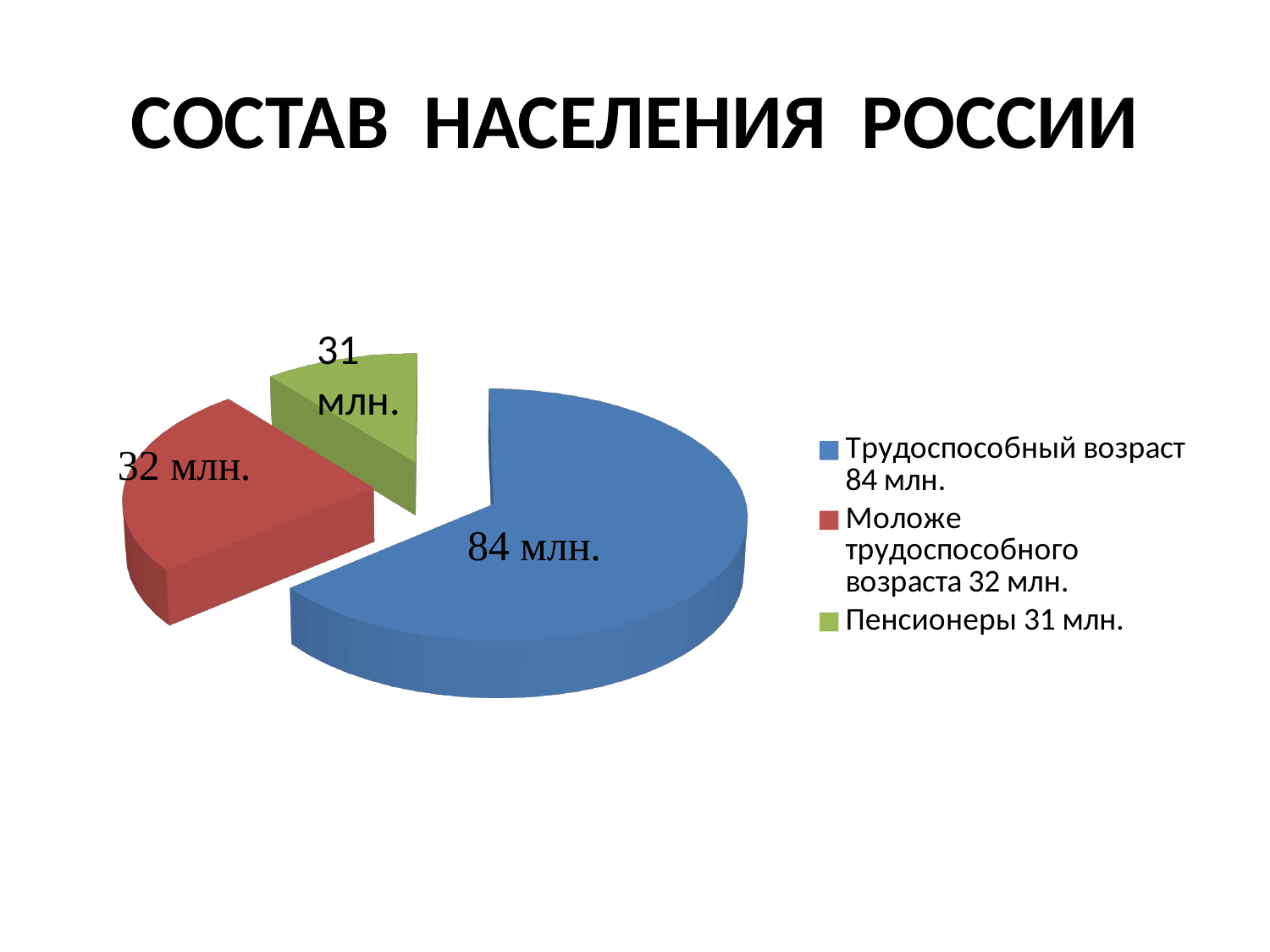
Which category has the largest slice of the pie? Трудоспособный возраст What value is shown for the Трудоспособный возраст slice? 84 млн. What is the difference between the Трудоспособный возраст value and the Пенсионеры value? 53 млн. How many entries does the legend list? 3 What value is shown for the Моложе трудоспособного возраста slice? 32 млн. How many slices does the pie chart have? 3 What type of chart is shown on the slide? Pie chart What value is shown for the Пенсионеры slice? 31 млн. What is the title of the slide's chart? СОСТАВ НАСЕЛЕНИЯ РОССИИ Which category has the smallest slice of the pie? Пенсионеры Which is larger: the value for Моложе трудоспособного возраста or the value for Пенсионеры? Моложе трудоспособного возраста What colour is the Трудоспособный возраст slice? Blue